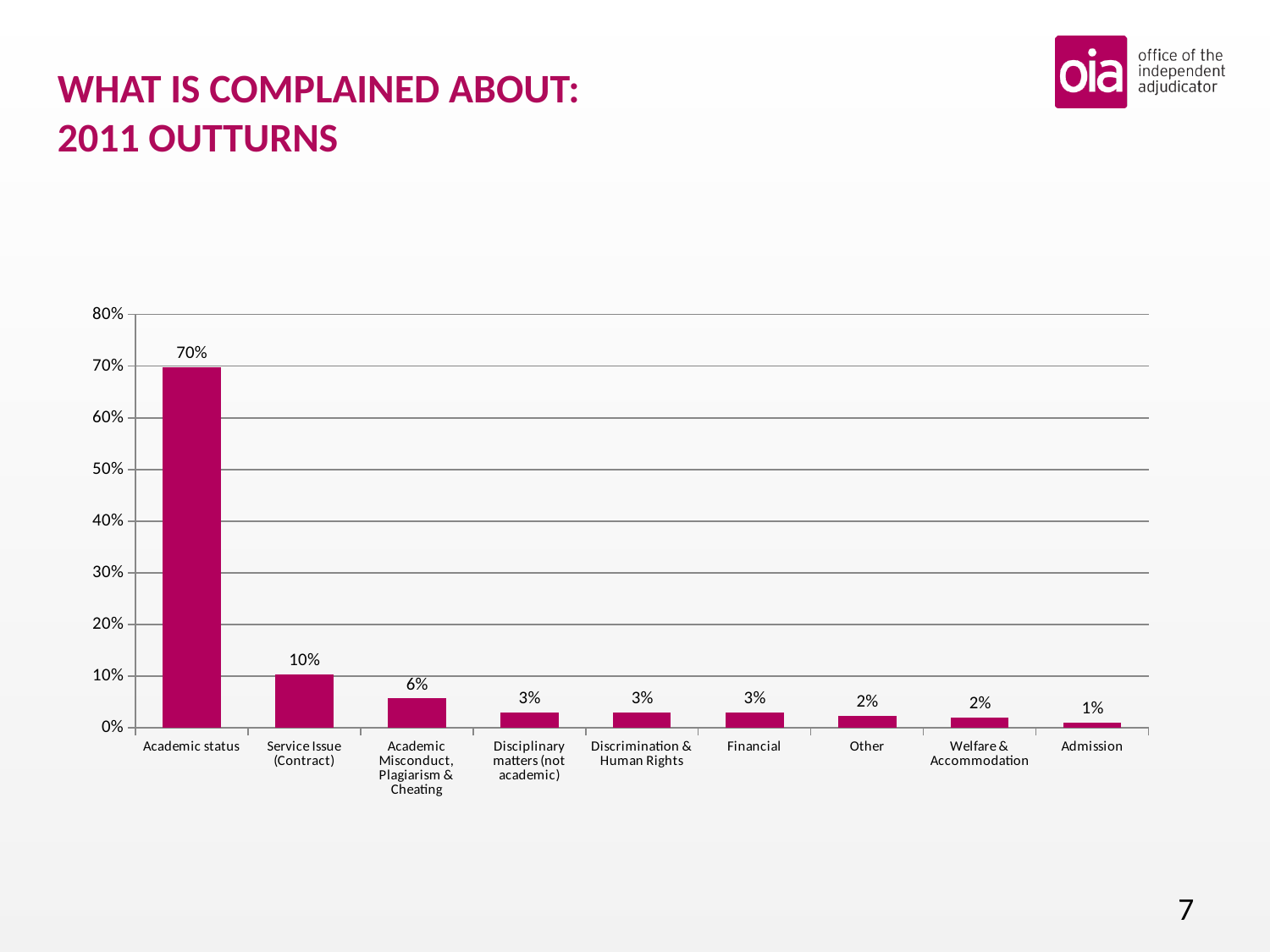
Which is larger, the value for Financial or the value for Other? Financial What is the value for Service Issue (Contract)? 10% What is the value for Academic Misconduct, Plagiarism & Cheating? 6% Is the value for Academic status greater or less than 60%? greater Which category has the highest value? Academic status Which category has the lowest value? Admission What is the value for Academic status? 70% How many categories are shown on the x axis? 9 Do the values rise or fall from left to right along the x axis? fall What is the difference between the values for Academic status and Service Issue (Contract)? 60% What kind of chart is shown on the slide? bar chart What is the value for Welfare & Accommodation? 2%